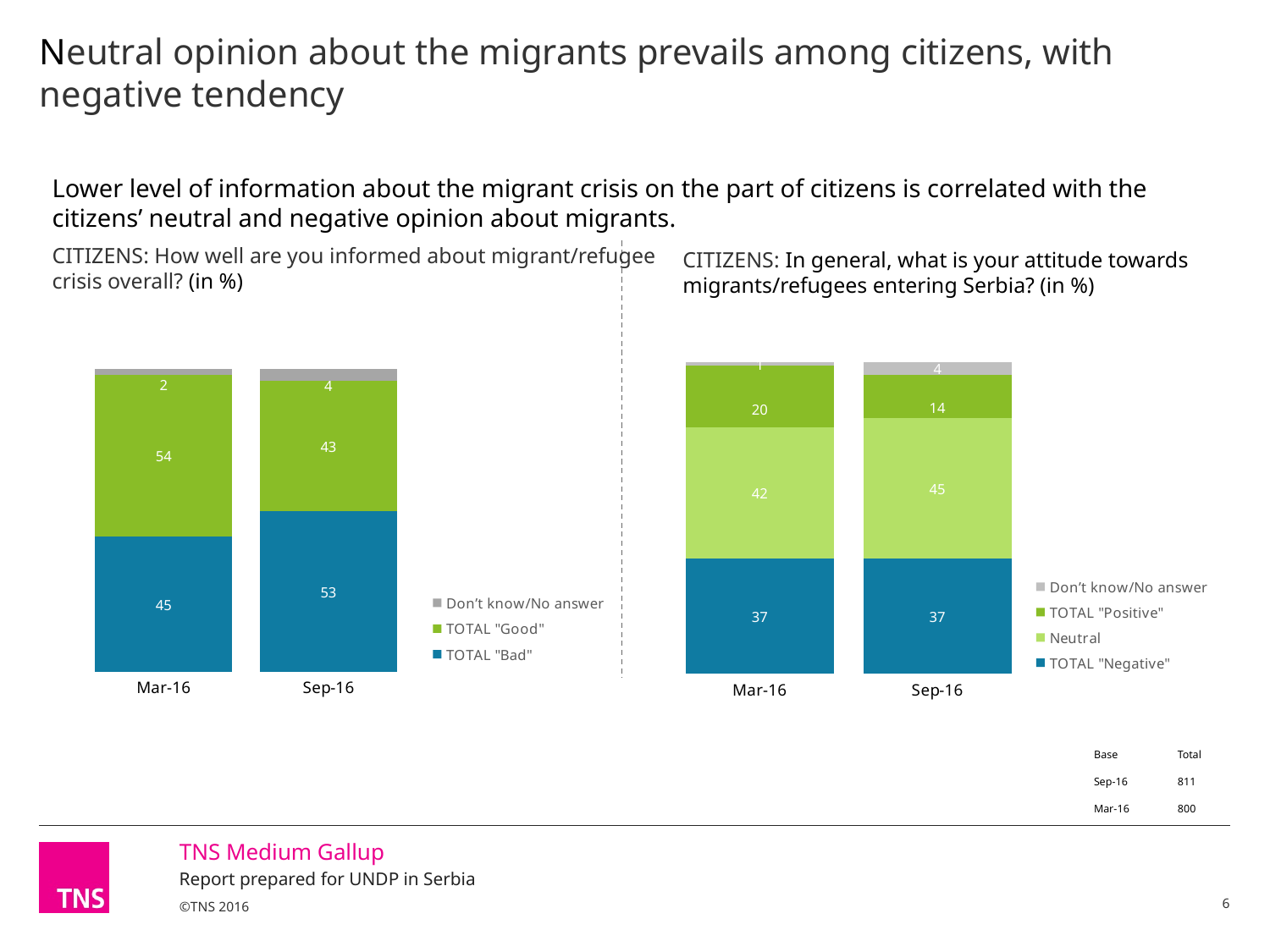
What type of chart is the left chart (How well are you informed about migrant/refugee crisis overall?)? Stacked bar chart In the right chart (attitude towards migrants/refugees entering Serbia), what is the difference in TOTAL "Positive" between Mar-16 and Sep-16? 6 In the left chart (How well are you informed about migrant/refugee crisis overall?), what is the Don't know/No answer value for Sep-16? 4 In the right chart (attitude towards migrants/refugees entering Serbia), what is the TOTAL "Positive" value for Mar-16? 20 How many series does the legend of the right chart (attitude towards migrants/refugees entering Serbia) list? 4 In the left chart (How well are you informed about migrant/refugee crisis overall?), what is the value for TOTAL "Bad" in Sep-16? 53 In the right chart (attitude towards migrants/refugees entering Serbia), what is the total of the Sep-16 stacked bar? 100 In the left chart (How well are you informed about migrant/refugee crisis overall?), which is larger in Sep-16: TOTAL "Good" or TOTAL "Bad"? TOTAL "Bad" In the right chart (attitude towards migrants/refugees entering Serbia), what is the Neutral value for Sep-16? 45 In the right chart (attitude towards migrants/refugees entering Serbia), what is the TOTAL "Negative" value for Sep-16? 37 In the left chart (How well are you informed about migrant/refugee crisis overall?), by how much did TOTAL "Bad" change from Mar-16 to Sep-16? 8 In the left chart (How well are you informed about migrant/refugee crisis overall?), what is the value for TOTAL "Good" in Mar-16? 54